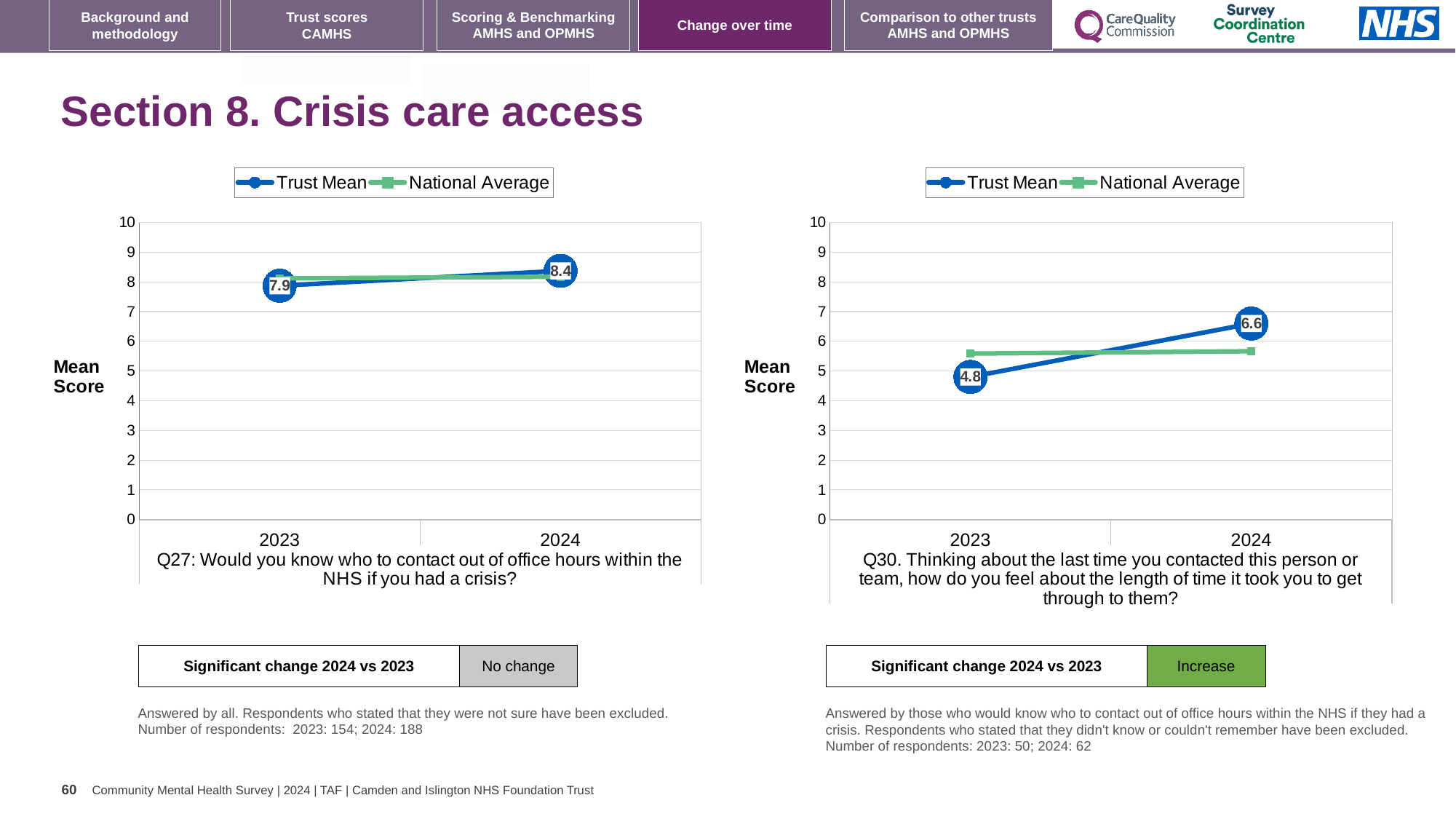
In the right chart (Q30), is the National Average value for 2023 greater or less than 5? greater In the right chart (Q30), what is the Trust Mean value for 2024? 6.6 What type of chart is the left chart (Q27)? line chart How many series does the legend of the left chart (Q27) list? 2 In the left chart (Q27), what is the Trust Mean value for 2023? 7.9 In the left chart (Q27), what is the difference between the Trust Mean values for 2024 and 2023? 0.5 In the right chart (Q30), does the Trust Mean rise or fall from 2023 to 2024? rise In the right chart (Q30), what is the difference between the Trust Mean values for 2024 and 2023? 1.8 In the right chart (Q30), which is larger in 2024, the Trust Mean or the National Average? Trust Mean In the left chart (Q27), what is the Trust Mean value for 2024? 8.4 In the right chart (Q30), what is the Trust Mean value for 2023? 4.8 How many years are plotted on the x axis of the right chart (Q30)? 2